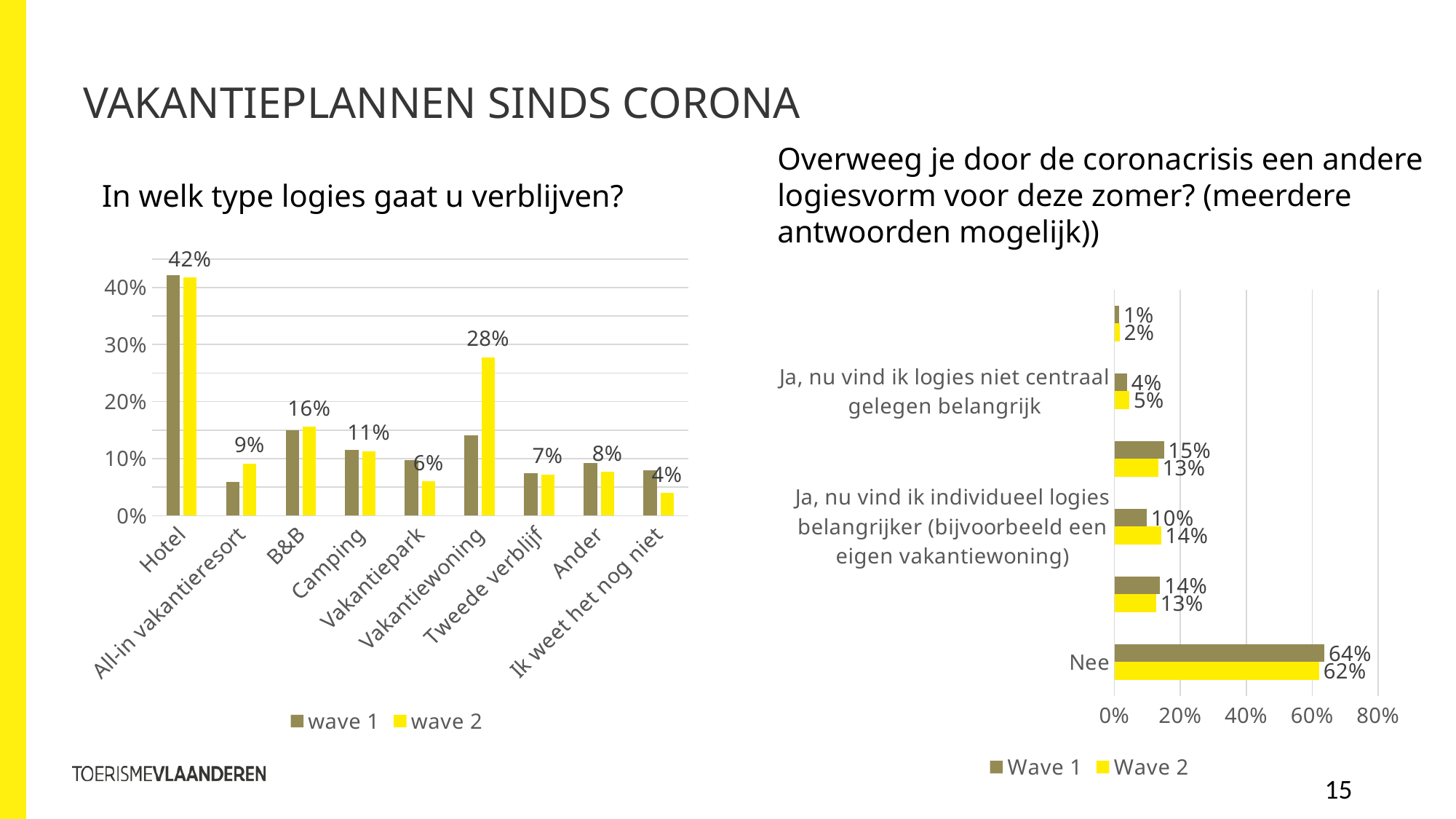
In the left chart 'In welk type logies gaat u verblijven?', what is the wave 2 value for Vakantiewoning? 28% What kind of chart is the left chart titled 'In welk type logies gaat u verblijven?'? bar chart In the left chart 'In welk type logies gaat u verblijven?', is the wave 1 value for Vakantiewoning greater or less than 20%? less In the left chart 'In welk type logies gaat u verblijven?', how many series does the legend list? 2 In the right chart 'Overweeg je door de coronacrisis een andere logiesvorm voor deze zomer?', which is larger for 'Ja, nu vind ik logies niet centraal gelegen belangrijk': Wave 1 or Wave 2? Wave 2 In the left chart 'In welk type logies gaat u verblijven?', what is the wave 2 value for Hotel? 42% In the left chart 'In welk type logies gaat u verblijven?', which category has the highest wave 2 value? Hotel In the right chart 'Overweeg je door de coronacrisis een andere logiesvorm voor deze zomer?', what is the Wave 2 value for 'Ja, nu vind ik individueel logies belangrijker (bijvoorbeeld een eigen vakantiewoning)'? 14% In the right chart 'Overweeg je door de coronacrisis een andere logiesvorm voor deze zomer?', what is the difference between the Wave 1 and Wave 2 values for 'Nee'? 2 percentage points In the right chart 'Overweeg je door de coronacrisis een andere logiesvorm voor deze zomer?', which category has the highest values? Nee In the left chart 'In welk type logies gaat u verblijven?', how many accommodation categories are shown on the x axis? 9 In the right chart 'Overweeg je door de coronacrisis een andere logiesvorm voor deze zomer?', what is the Wave 1 value for 'Nee'? 64%